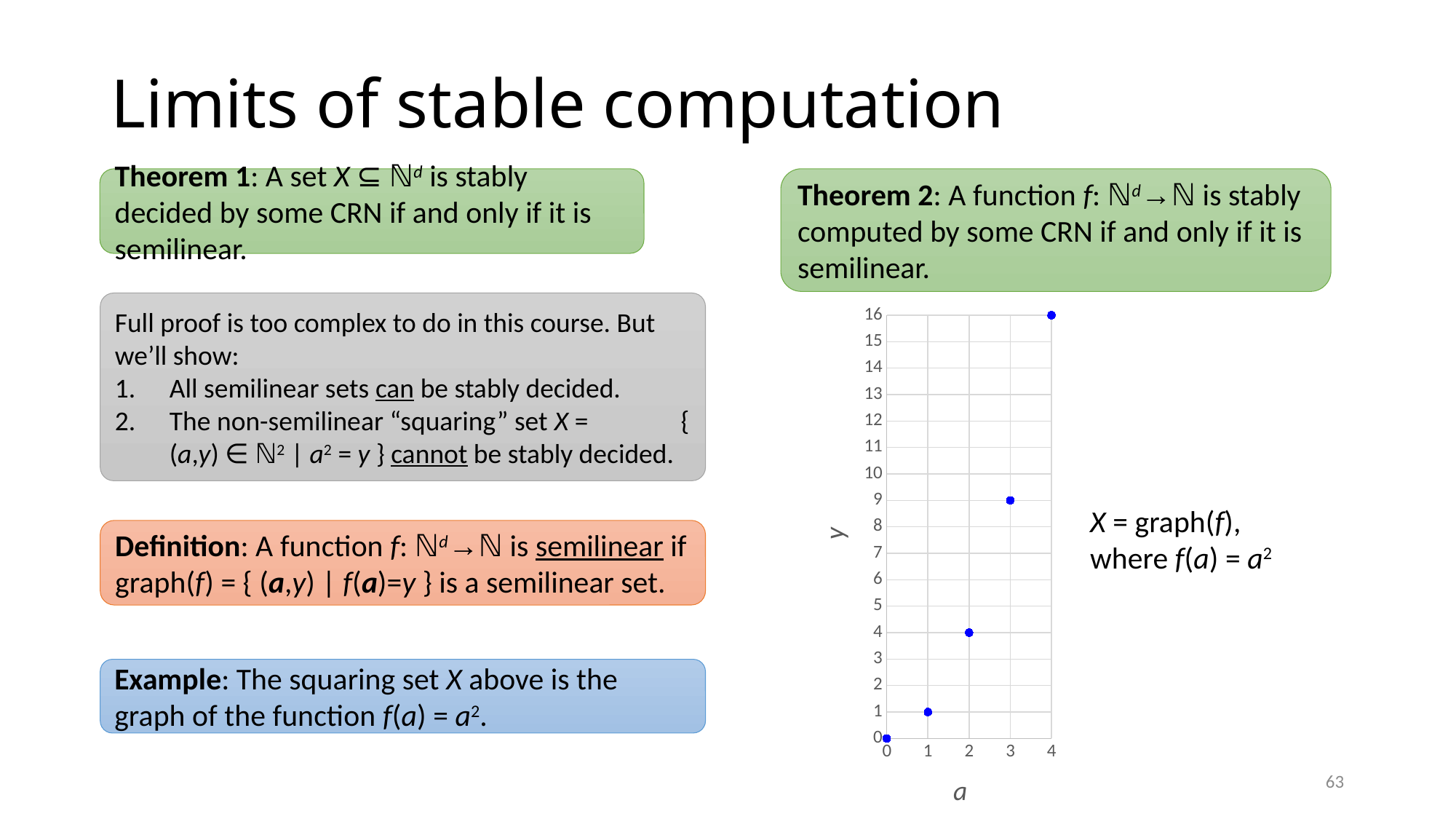
What is the y value of the point at a = 2? 4 Which point has a larger y value, the one at a = 2 or the one at a = 3? a = 3 At which value of a is y lowest? 0 What is the y value of the point at a = 4? 16 How many data points are plotted in the chart? 5 What is the label of the x axis of the chart? a What is the difference in y between the points at a = 4 and a = 3? 7 Do the y values rise or fall as a increases along the x axis? rise What is the y value of the point at a = 1? 1 What is the y value of the point at a = 3? 9 At which value of a is y highest? 4 What kind of chart is shown on the slide? scatter plot